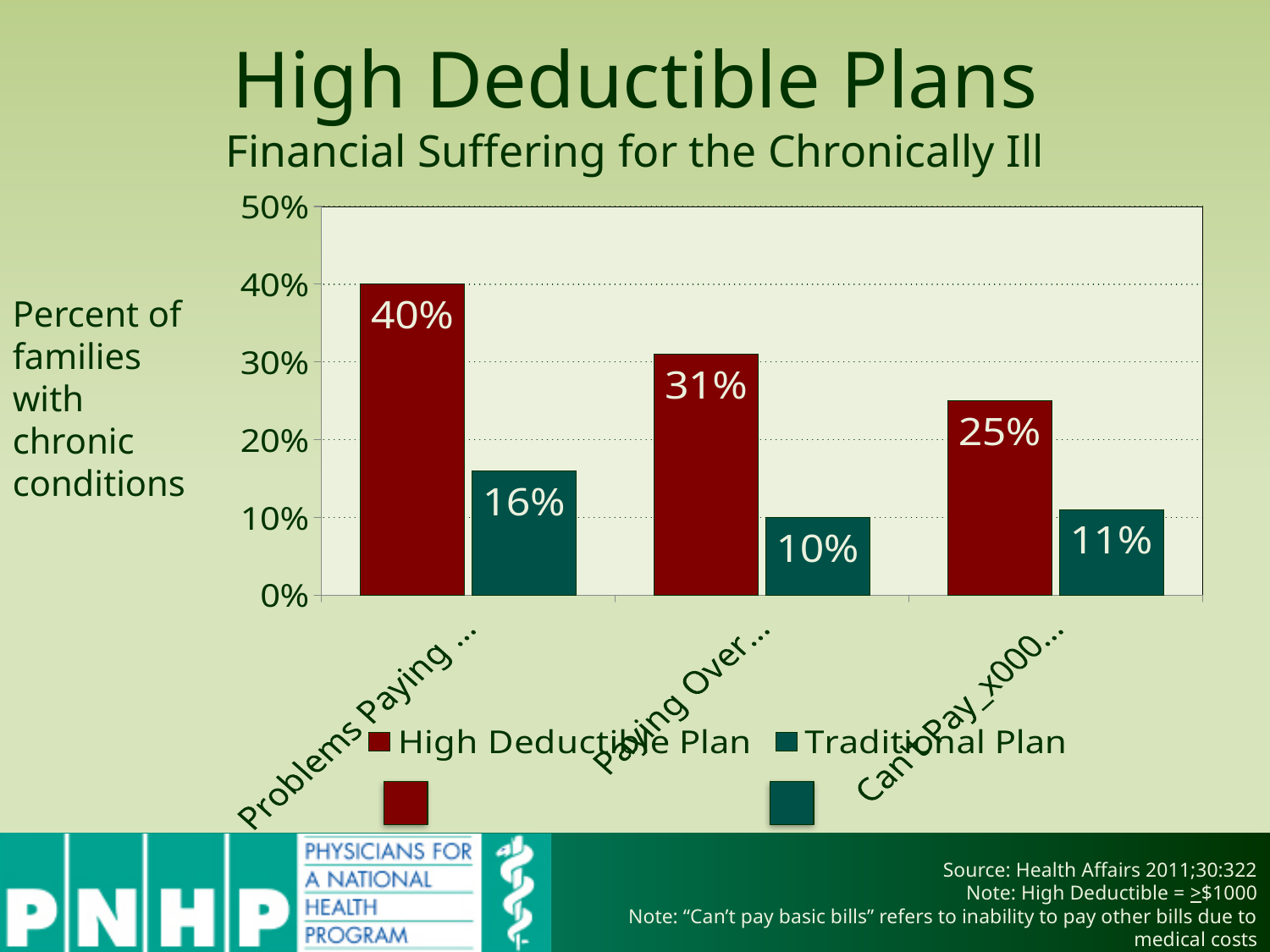
What kind of chart is shown on the slide? bar chart Do the High Deductible Plan values rise or fall from left to right across the three groups? fall What is the value of the High Deductible Plan bar in the first (leftmost) group of bars? 40% How many groups of bars (categories) are plotted on the chart? 3 What is the value of the High Deductible Plan bar in the middle group of bars? 31% What is the value of the Traditional Plan bar in the first (leftmost) group of bars? 16% Which bar on the chart has the lowest value? Traditional Plan in the middle group, 10% What is the difference between the High Deductible Plan and Traditional Plan values in the first (leftmost) group of bars? 24% Which bar on the chart has the highest value? High Deductible Plan in the first (leftmost) group, 40% In the third (rightmost) group of bars, which is larger: the High Deductible Plan value or the Traditional Plan value? High Deductible Plan How many series does the chart legend list? 2 What is the value of the Traditional Plan bar in the third (rightmost) group of bars? 11%